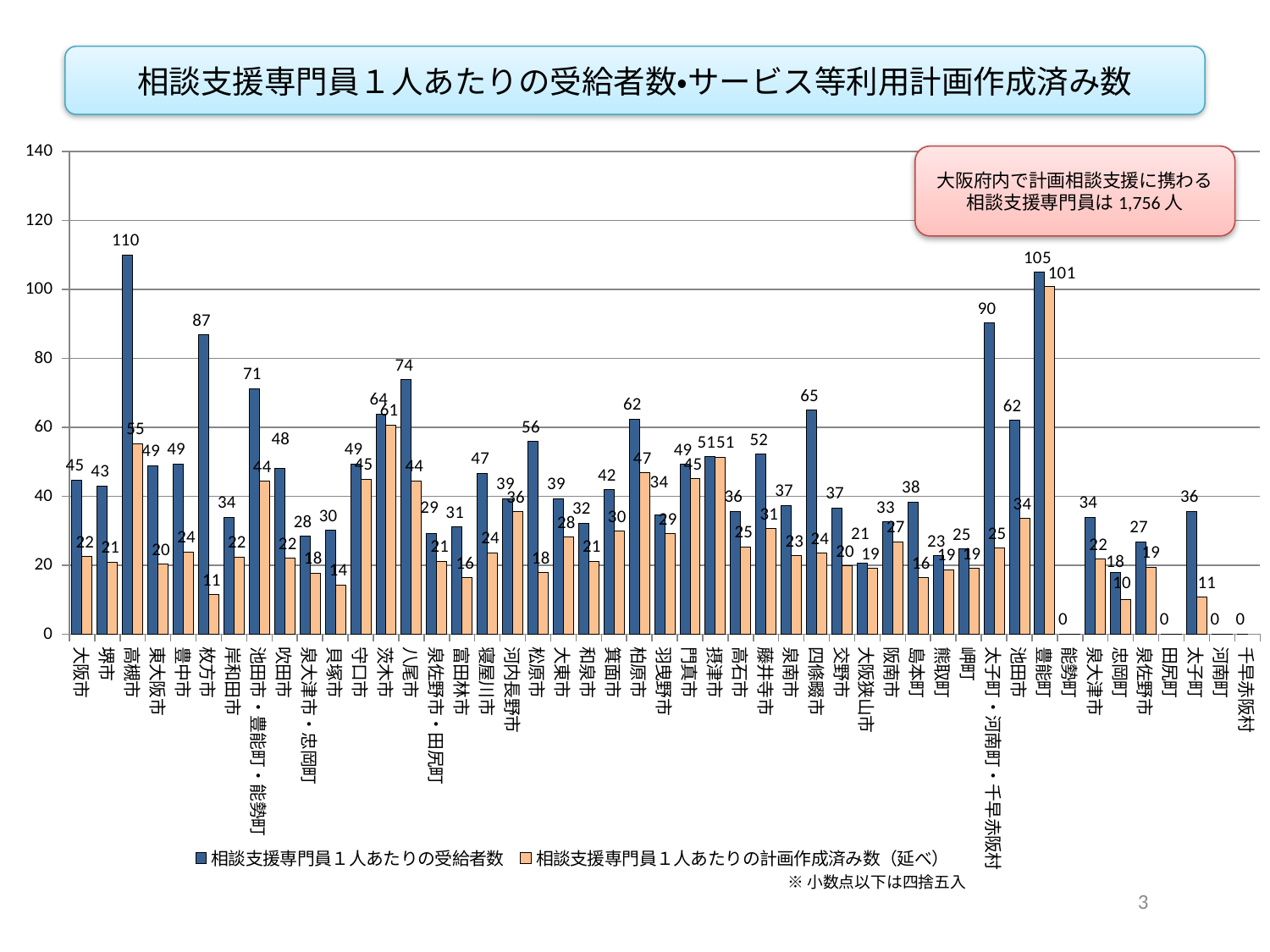
What is the title of the chart? 相談支援専門員１人あたりの受給者数•サービス等利用計画作成済み数 What is the value of 相談支援専門員１人あたりの受給者数 for 高槻市? 110 What is the value of 相談支援専門員１人あたりの受給者数 for 枚方市? 87 What is the value of 相談支援専門員１人あたりの計画作成済み数（延べ） for 豊能町? 101 Which category has the highest value of 相談支援専門員１人あたりの計画作成済み数（延べ）? 豊能町 Which category has the highest value of 相談支援専門員１人あたりの受給者数? 高槻市 What is the value of 相談支援専門員１人あたりの計画作成済み数（延べ） for 茨木市? 61 What is the difference between 相談支援専門員１人あたりの受給者数 and 相談支援専門員１人あたりの計画作成済み数（延べ） for 高槻市? 55 How many series does the legend list? 2 What kind of chart is shown on the slide? bar chart Is the value of 相談支援専門員１人あたりの受給者数 for 太子町・河南町・千早赤阪村 greater or less than 80? greater Which is larger: 相談支援専門員１人あたりの受給者数 for 枚方市 or for 八尾市? 枚方市